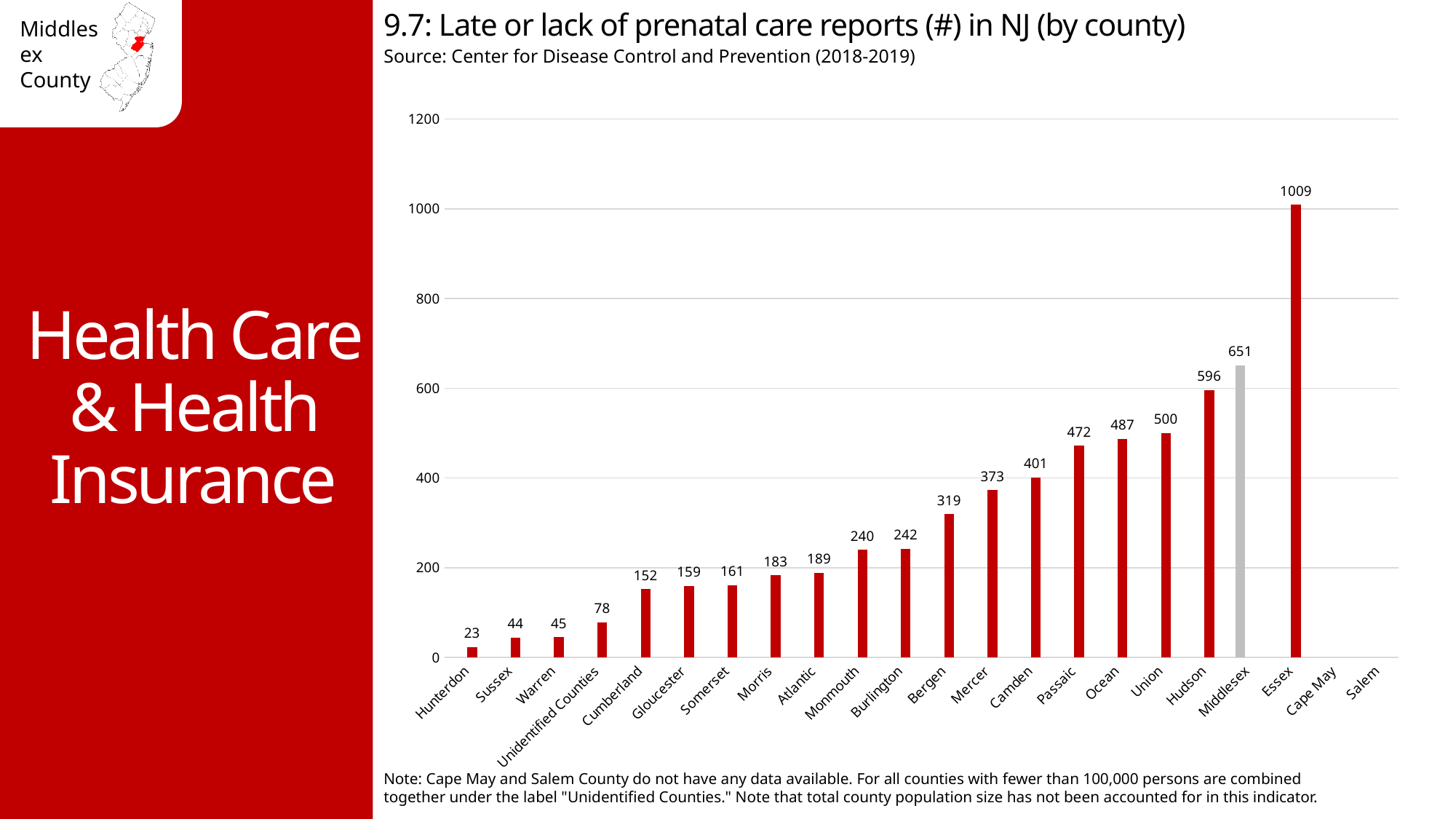
Which has a higher value, Bergen or Mercer? Mercer Is the value for Camden greater or less than 400? greater Which county has the highest number of late or lack of prenatal care reports? Essex What type of chart is shown on the slide? Bar chart Which county has the lowest number of late or lack of prenatal care reports? Hunterdon What is the difference between the values for Union and Passaic? 28 How many county labels are shown on the x axis? 22 What is the difference between the values for Essex and Middlesex? 358 What is the number of late or lack of prenatal care reports for Middlesex County? 651 What is the value shown for Hudson County? 596 What is the value shown for Unidentified Counties? 78 Which bar is shown in grey instead of red? Middlesex